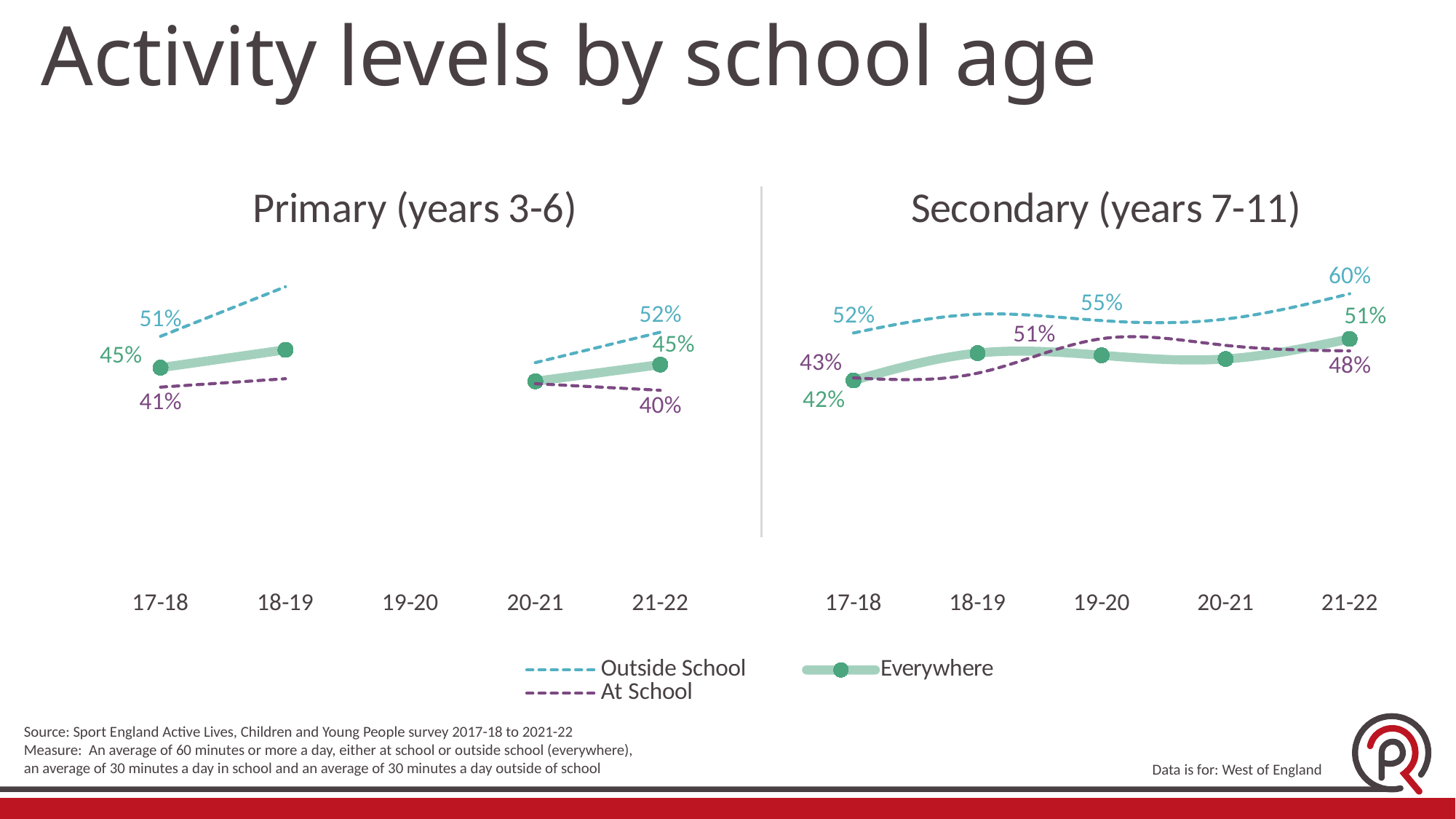
What kind of chart is used on this slide? Line chart In the Secondary (years 7-11) chart, what is the Everywhere value for 17-18? 42% In the Primary (years 3-6) chart, which is larger in 21-22: the Outside School value or the At School value? Outside School In the Secondary (years 7-11) chart, by how many percentage points did the Outside School value change from 17-18 to 21-22? 8 percentage points In the Primary (years 3-6) chart, what is the At School value for 21-22? 40% In the Secondary (years 7-11) chart, does the Everywhere series rise or fall from 17-18 to 21-22? Rise In the Secondary (years 7-11) chart, what is the At School value for 21-22? 48% What is the title of the chart on the right side of the slide? Secondary (years 7-11) How many series does the legend list? 3 In the Secondary (years 7-11) chart, how many data points are plotted for the Everywhere series? 5 In the Primary (years 3-6) chart, what is the Outside School value for 17-18? 51% In the Secondary (years 7-11) chart, what is the Outside School value for 21-22? 60%